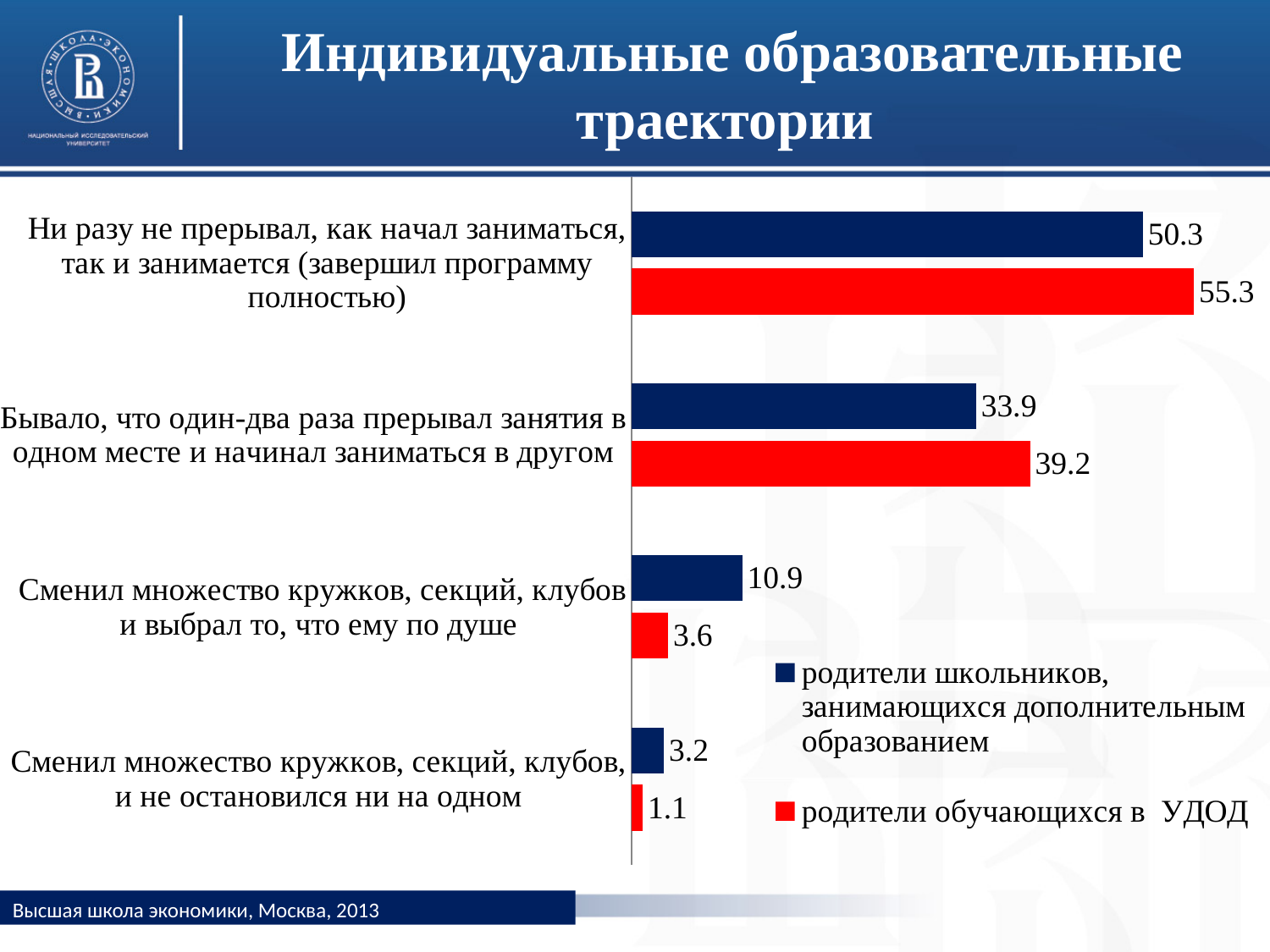
How many series does the legend list? 2 Which category has the highest value for 'родители обучающихся в УДОД'? Ни разу не прерывал, как начал заниматься, так и занимается (завершил программу полностью) What value is shown for 'родители обучающихся в УДОД' in the category 'Сменил множество кружков, секций, клубов и выбрал то, что ему по душе'? 3.6 What kind of chart is shown on the slide? Bar chart What is the difference between the two series' values in the category 'Сменил множество кружков, секций, клубов и выбрал то, что ему по душе'? 7.3 Which category has the lowest value for 'родители школьников, занимающихся дополнительным образованием'? Сменил множество кружков, секций, клубов, и не остановился ни на одном What value is shown for 'родители обучающихся в УДОД' in the category 'Ни разу не прерывал, как начал заниматься, так и занимается (завершил программу полностью)'? 55.3 In the category 'Бывало, что один-два раза прерывал занятия в одном месте и начинал заниматься в другом', which series has the larger value? родители обучающихся в УДОД What value is shown for 'родители школьников, занимающихся дополнительным образованием' in the category 'Сменил множество кружков, секций, клубов, и не остановился ни на одном'? 3.2 What value is shown for 'родители школьников, занимающихся дополнительным образованием' in the category 'Бывало, что один-два раза прерывал занятия в одном месте и начинал заниматься в другом'? 33.9 What is the difference between the two series' values in the category 'Ни разу не прерывал, как начал заниматься, так и занимается (завершил программу полностью)'? 5.0 How many categories are shown on the chart? 4